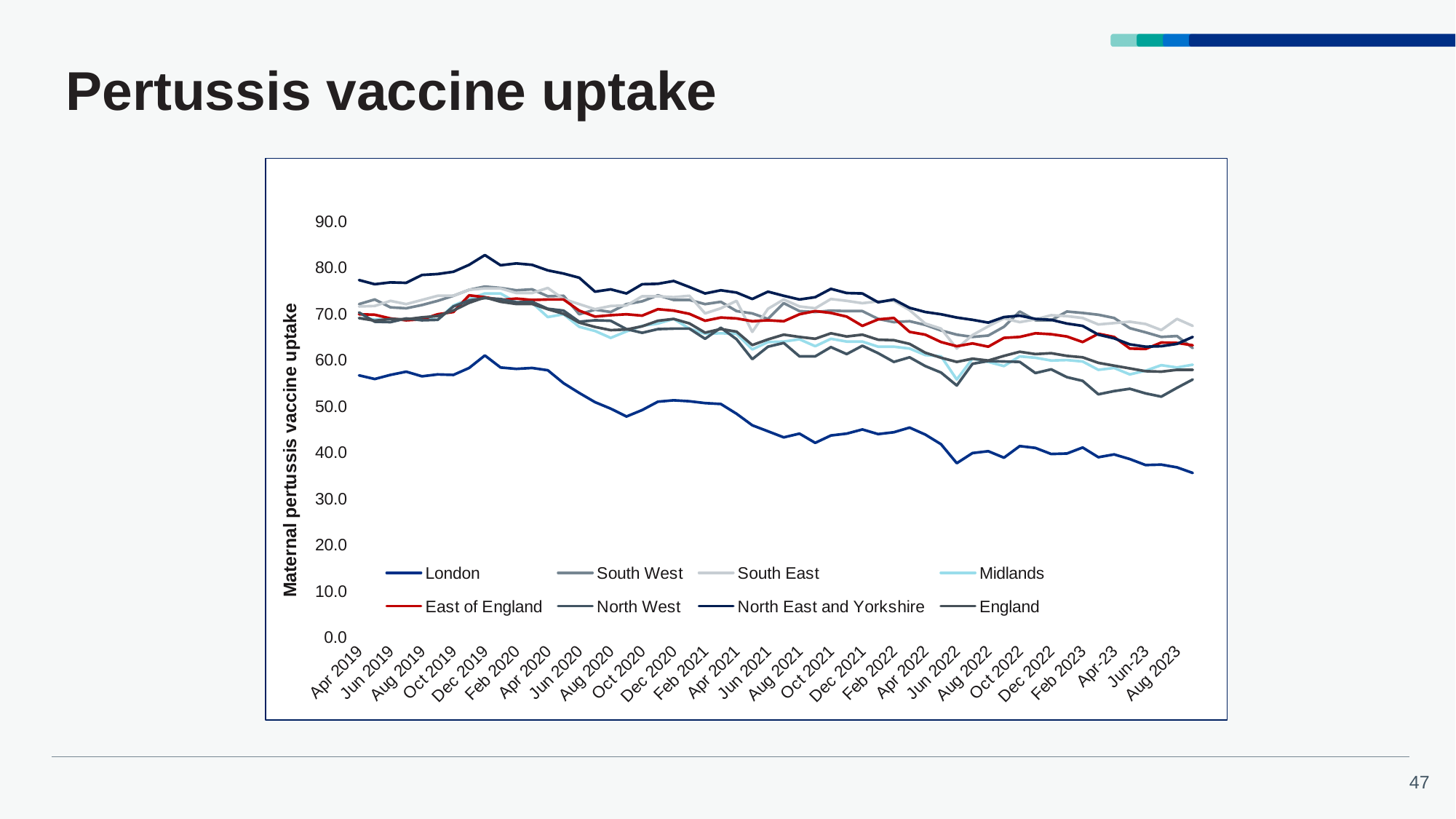
Which region has the lowest maternal pertussis vaccine uptake across the whole period? London Which region has the highest maternal pertussis vaccine uptake in Dec 2019? North East and Yorkshire How many series does the legend list? 8 How many date labels are shown on the x axis? 27 What kind of chart is shown on the slide? Line chart In Apr 2019, which is larger: the value for London or the value for North East and Yorkshire? North East and Yorkshire Is the value for North East and Yorkshire in Dec 2019 greater or less than 80.0? greater Is the value for London in Apr 2019 greater or less than 50.0? greater Is the value for London in Aug 2023 greater or less than 40.0? less Which series is drawn in red? East of England What is the label on the vertical axis? Maternal pertussis vaccine uptake Does the London line rise or fall from Apr 2019 to Aug 2023? Fall